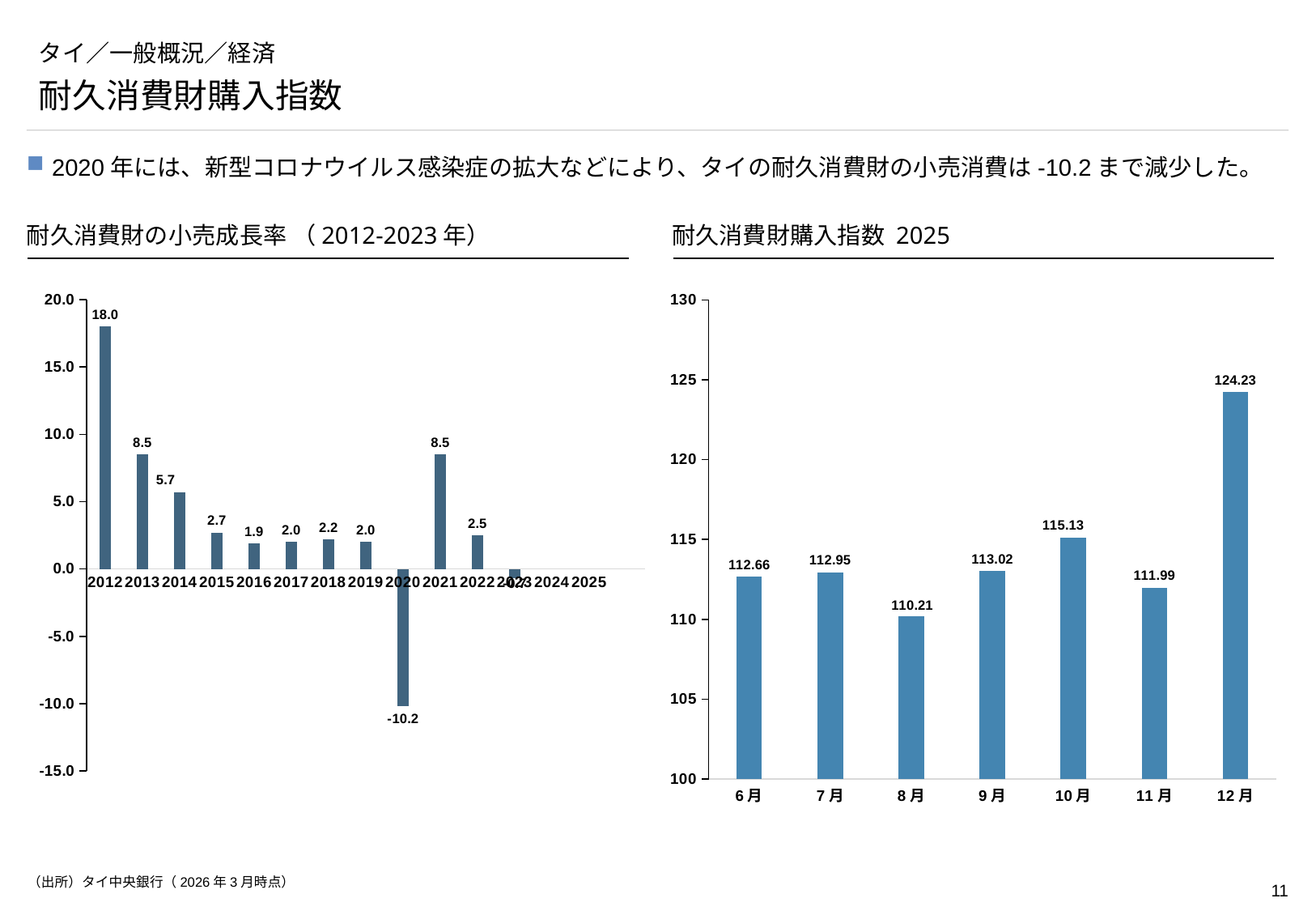
In the right chart (耐久消費財購入指数 2025), how many months are plotted? 7 In the left chart (耐久消費財の小売成長率), what is the difference between the values for 2013 and 2014? 2.8 In the right chart (耐久消費財購入指数 2025), what is the value for 10月? 115.13 What kind of chart is the right chart (耐久消費財購入指数 2025)? Bar chart In the left chart (耐久消費財の小売成長率), what is the value for 2020? -10.2 In the left chart (耐久消費財の小売成長率), which is larger, the value for 2015 or the value for 2016? 2015 In the right chart (耐久消費財購入指数 2025), which month has the lowest value? 8月 In the right chart (耐久消費財購入指数 2025), which month has the highest value? 12月 In the left chart (耐久消費財の小売成長率), what is the value for 2012? 18.0 In the left chart (耐久消費財の小売成長率), which year has the highest value? 2012 In the left chart (耐久消費財の小売成長率), which year has the lowest value? 2020 In the right chart (耐久消費財購入指数 2025), what is the difference between the values for 12月 and 11月? 12.24